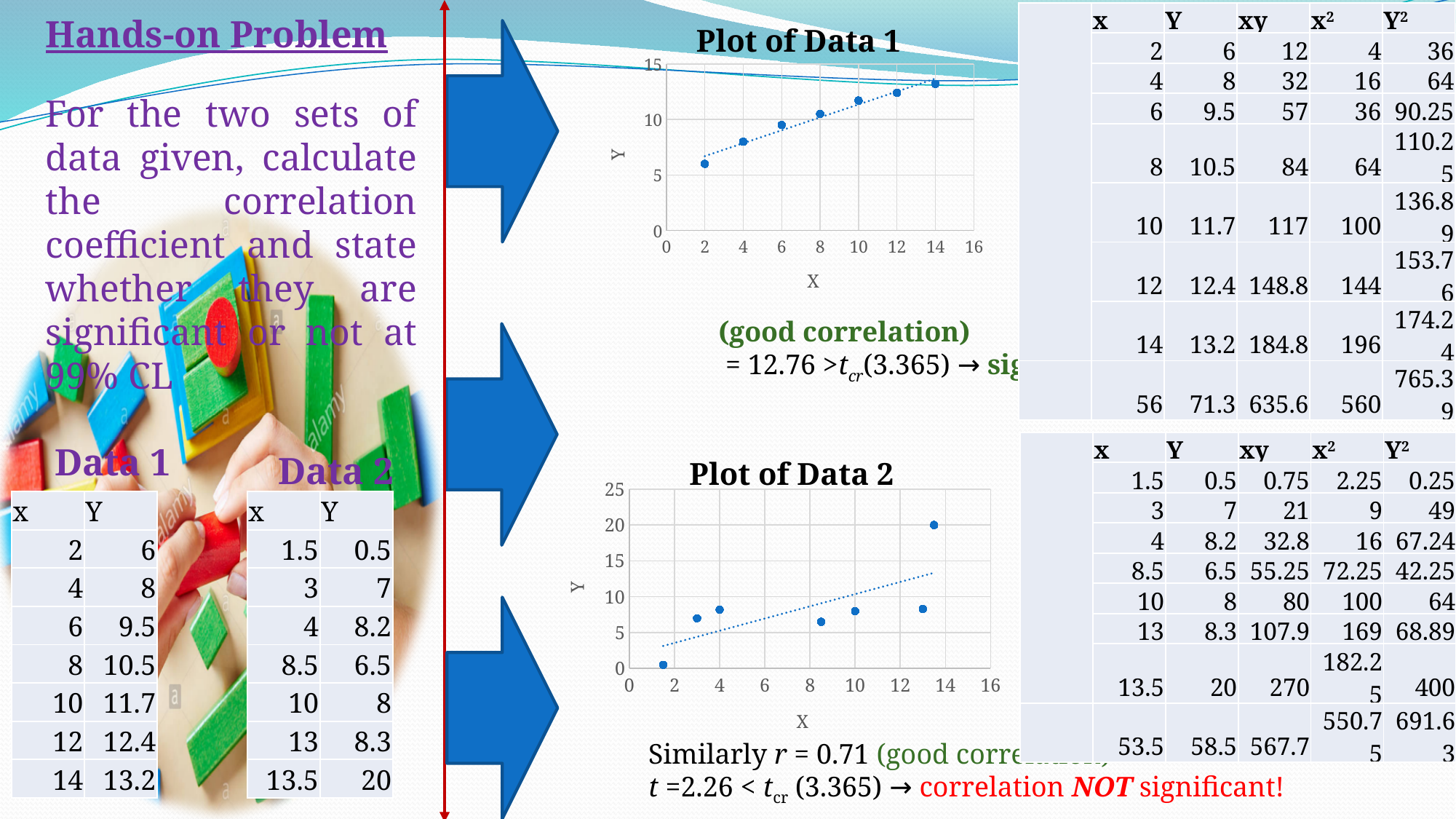
What is the highest tick value shown on the x axis of "Plot of Data 2"? 16 In "Plot of Data 1", is the Y value at X = 2 greater or less than 10? less What is the highest Y value plotted in "Plot of Data 2"? 20 In "Plot of Data 2", is the Y value of the lowest point greater or less than 5? less How many data points are plotted in "Plot of Data 2"? 7 How many data points are plotted in "Plot of Data 1"? 7 In "Plot of Data 2", is the Y value at X = 10 greater or less than 5? greater What kind of chart is "Plot of Data 1"? Scatter chart In "Plot of Data 1", do the Y values rise or fall as X increases? Rise What is the title of the upper chart on the slide? Plot of Data 1 In "Plot of Data 1", which point has the larger Y value, the one at X = 4 or the one at X = 12? X = 12